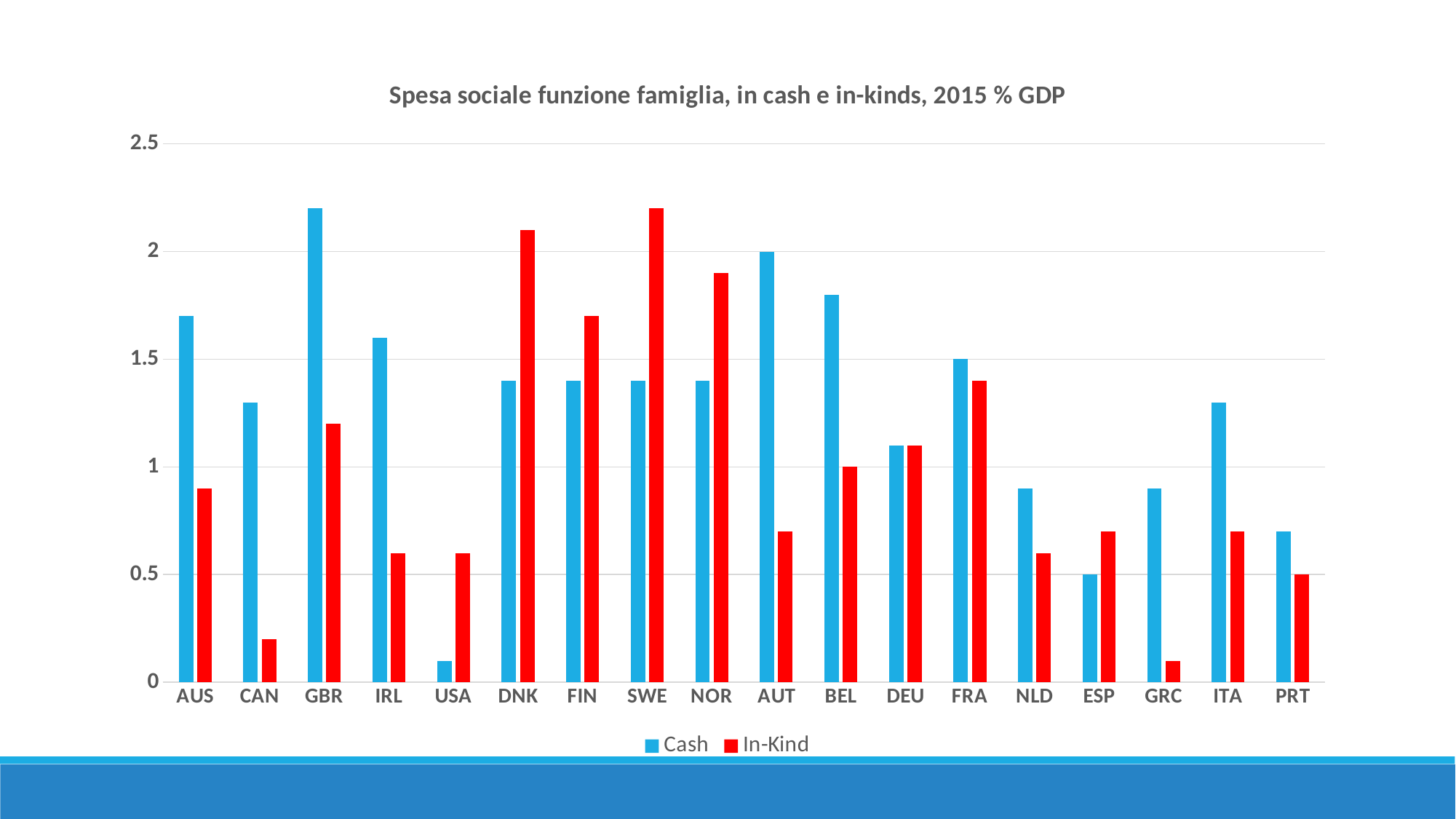
Is the Cash value for GBR greater or less than 2? greater Which country has the highest Cash value? GBR How many series does the legend list? 2 What is the Cash value for FRA? 1.5 Which colour represents the In-Kind series? Red How many countries are shown on the x axis? 18 Is the In-Kind value for CAN greater or less than 0.5? less What kind of chart is shown on the slide? Bar chart Which country has the lowest Cash value? USA What is the In-Kind value for BEL? 1 For DNK, which is larger, the Cash value or the In-Kind value? In-Kind What is the Cash value for AUT? 2